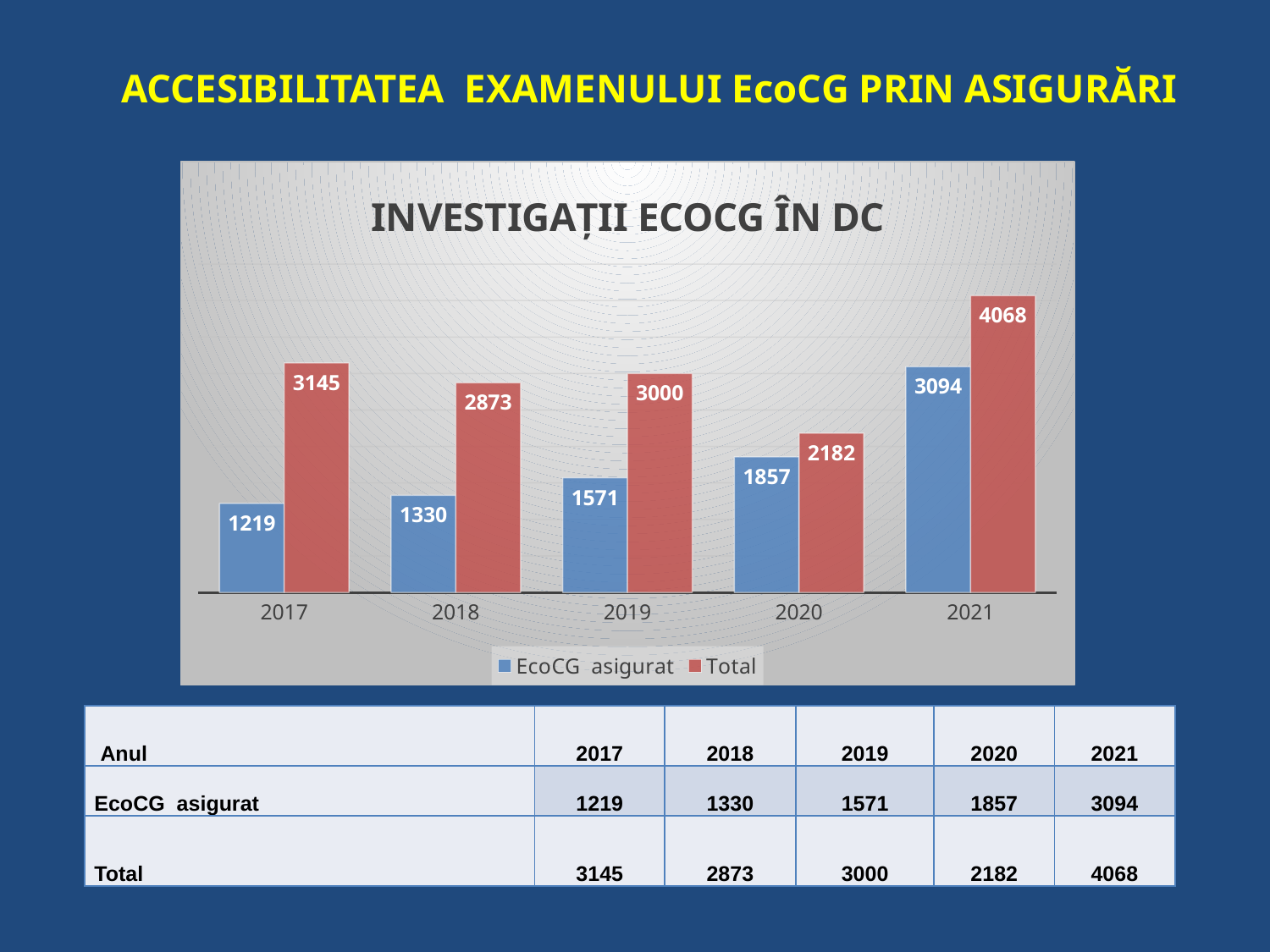
Does the EcoCG asigurat series rise or fall from 2017 to 2021? rise How many years are shown on the x axis? 5 Which colour represents the Total series? red What is the Total value for 2020? 2182 What is the value of EcoCG asigurat for 2019? 1571 What kind of chart is shown? bar chart Which year has the lowest EcoCG asigurat value? 2017 How many series does the legend list? 2 Which year has the highest Total value? 2021 What is the difference between Total and EcoCG asigurat in 2017? 1926 Which is larger: the Total for 2018 or the Total for 2019? Total for 2019 What is the title of the chart? INVESTIGAȚII ECOCG ÎN DC